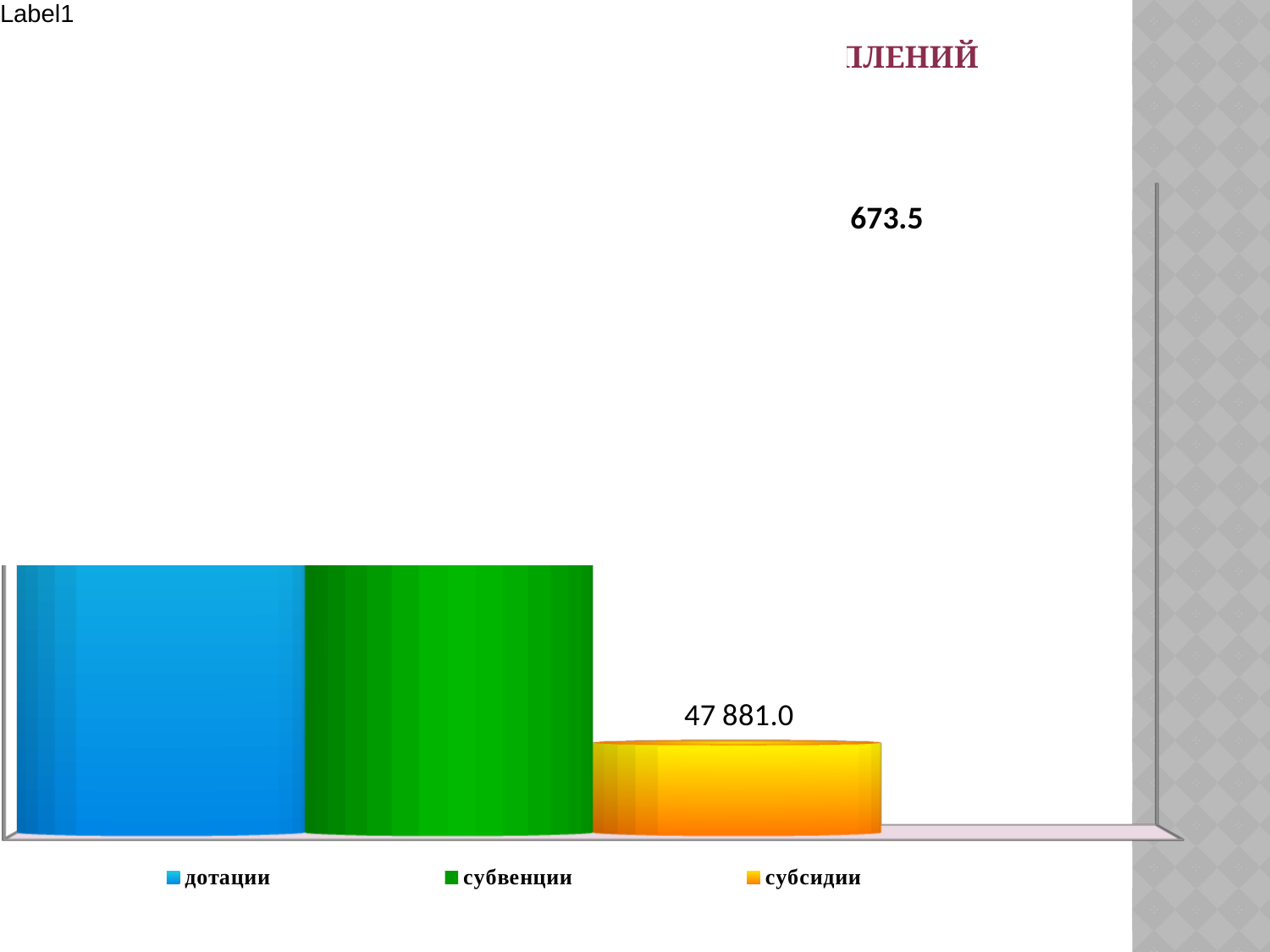
What is the value shown for субсидии? 47 881.0 How many bars are plotted in the chart? 3 What colour is the bar for субвенции? green How many series does the legend list? 3 Which is larger, the value for дотации or the value for субсидии? дотации Which legend entry is shown in blue? дотации Which is larger, the value for субвенции or the value for субсидии? субвенции What kind of chart is shown on the slide? bar chart Which category has the lowest value in the chart? субсидии